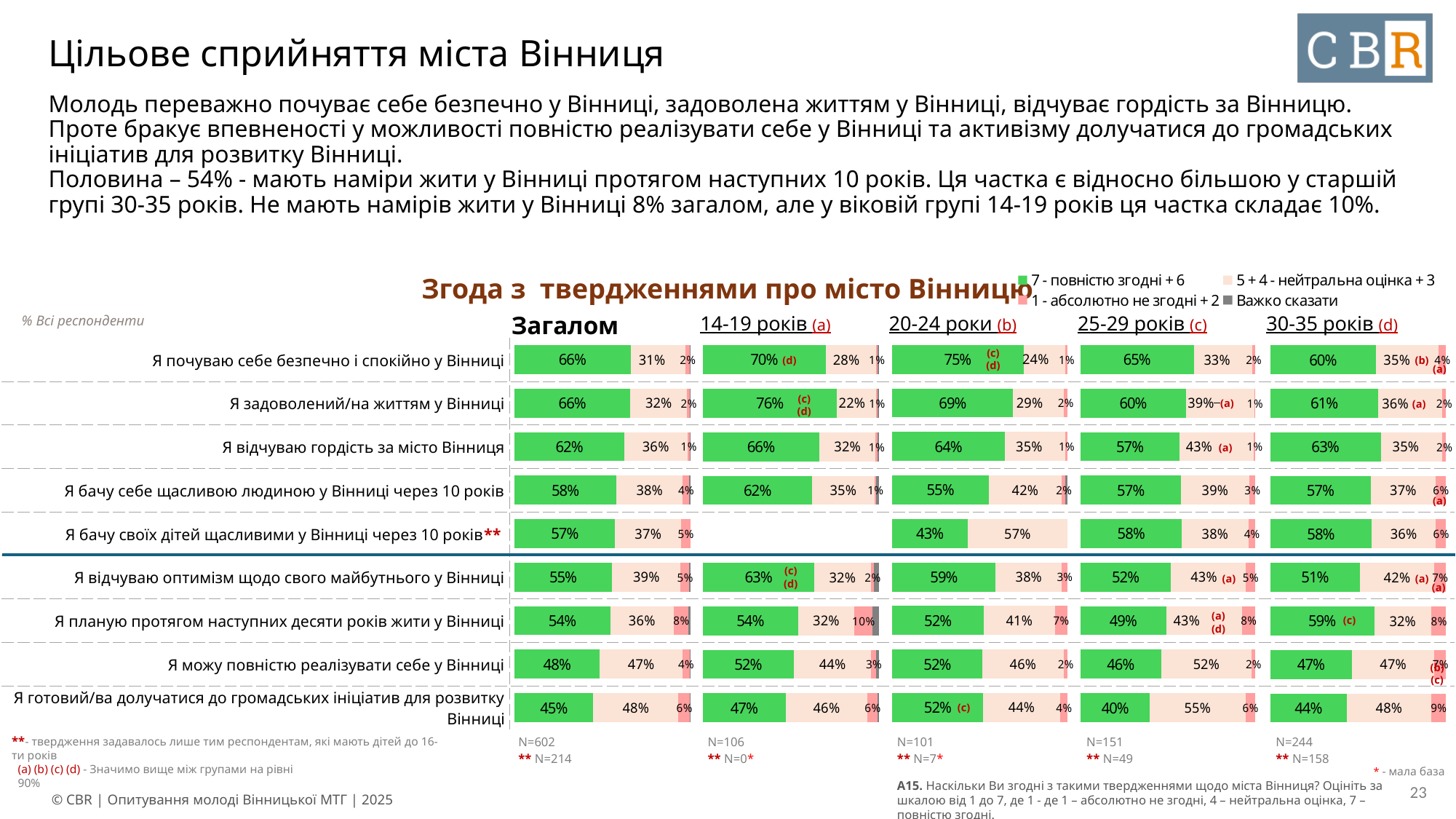
What is the sample size (N) shown under the '30-35 років' column? N=244 How many statements (rows) are plotted in the chart? 9 In the '14-19 років' column, what is the green (agree) value for 'Я задоволений/на життям у Вінниці'? 76% How many series does the chart legend list? 4 In the 'Загалом' column, what share fully agrees (green segment) with 'Я почуваю себе безпечно і спокійно у Вінниці'? 66% In the '20-24 роки' column, which statement has the highest green (agree) share? Я почуваю себе безпечно і спокійно у Вінниці What kind of chart is shown on the slide? Stacked bar chart For 'Я можу повністю реалізувати себе у Вінниці', which is larger in the 'Загалом' column: the green (agree) segment or the neutral segment? The green (agree) segment (48% vs 47%) In the '20-24 роки' column, what is the neutral (light) value for 'Я бачу своїх дітей щасливими у Вінниці через 10 років'? 57% What is the title of the chart? Згода з твердженнями про місто Вінницю In the 'Загалом' column, which statement has the lowest green (agree) share? Я готовий/ва долучатися до громадських ініціатив для розвитку Вінниці For 'Я планую протягом наступних десяти років жити у Вінниці', what is the difference between the green value in '30-35 років' (59%) and in '25-29 років' (49%)? 10 percentage points